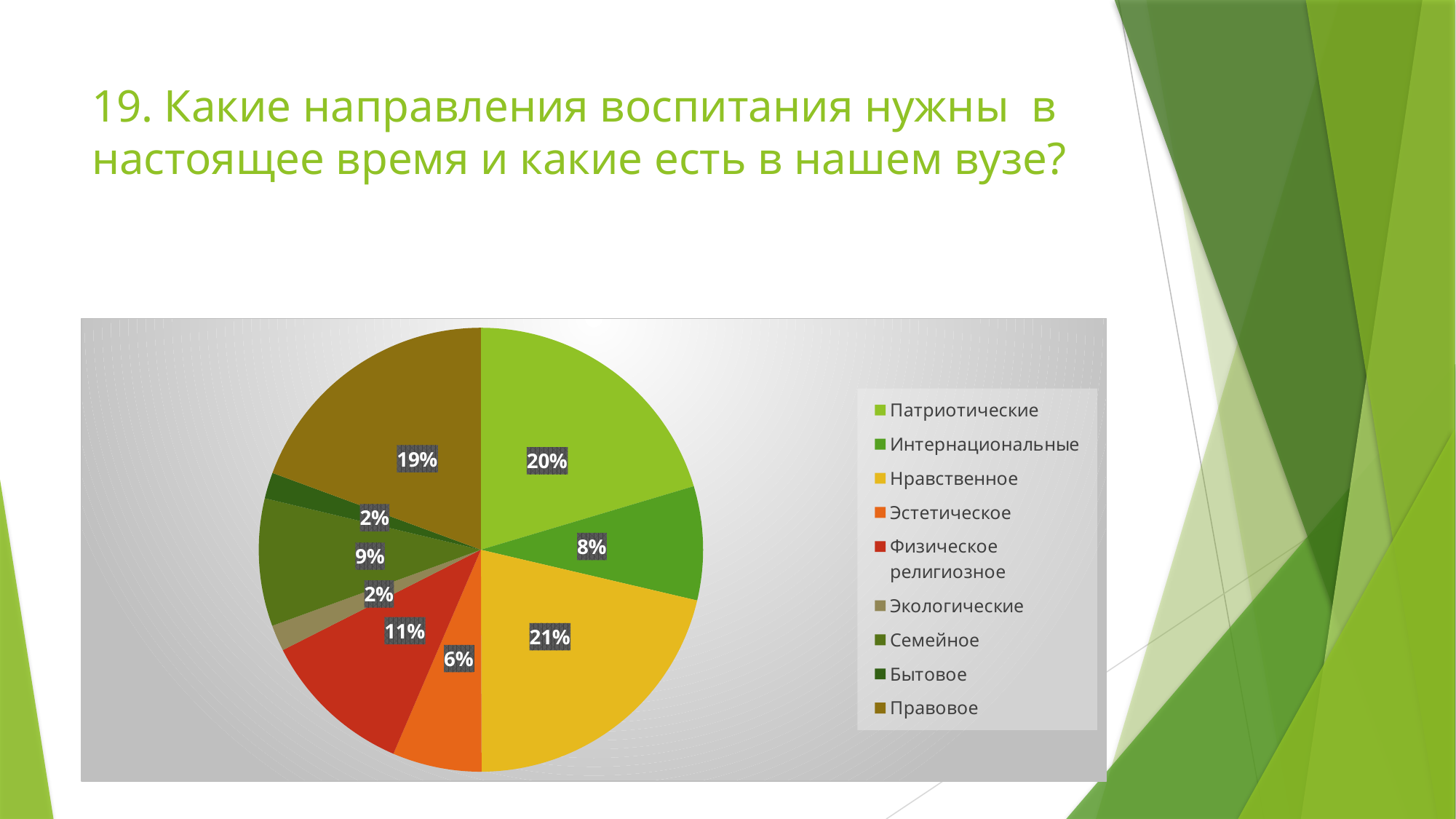
What share of the pie does Эстетическое have? 6% Which category has the largest share of the pie? Нравственное What share of the pie does Физическое религиозное have? 11% What colour is the slice for Правовое in the pie chart? brown What share of the pie does Нравственное have? 21% What share of the pie does Правовое have? 19% What kind of chart is shown on the slide? pie chart What is the difference between the shares for Нравственное and Правовое? 2% Which is larger, the share for Интернациональные or the share for Семейное? Семейное What share of the pie does Семейное have? 9% How many categories does the legend of the pie chart list? 9 What share of the pie does Патриотические have? 20%